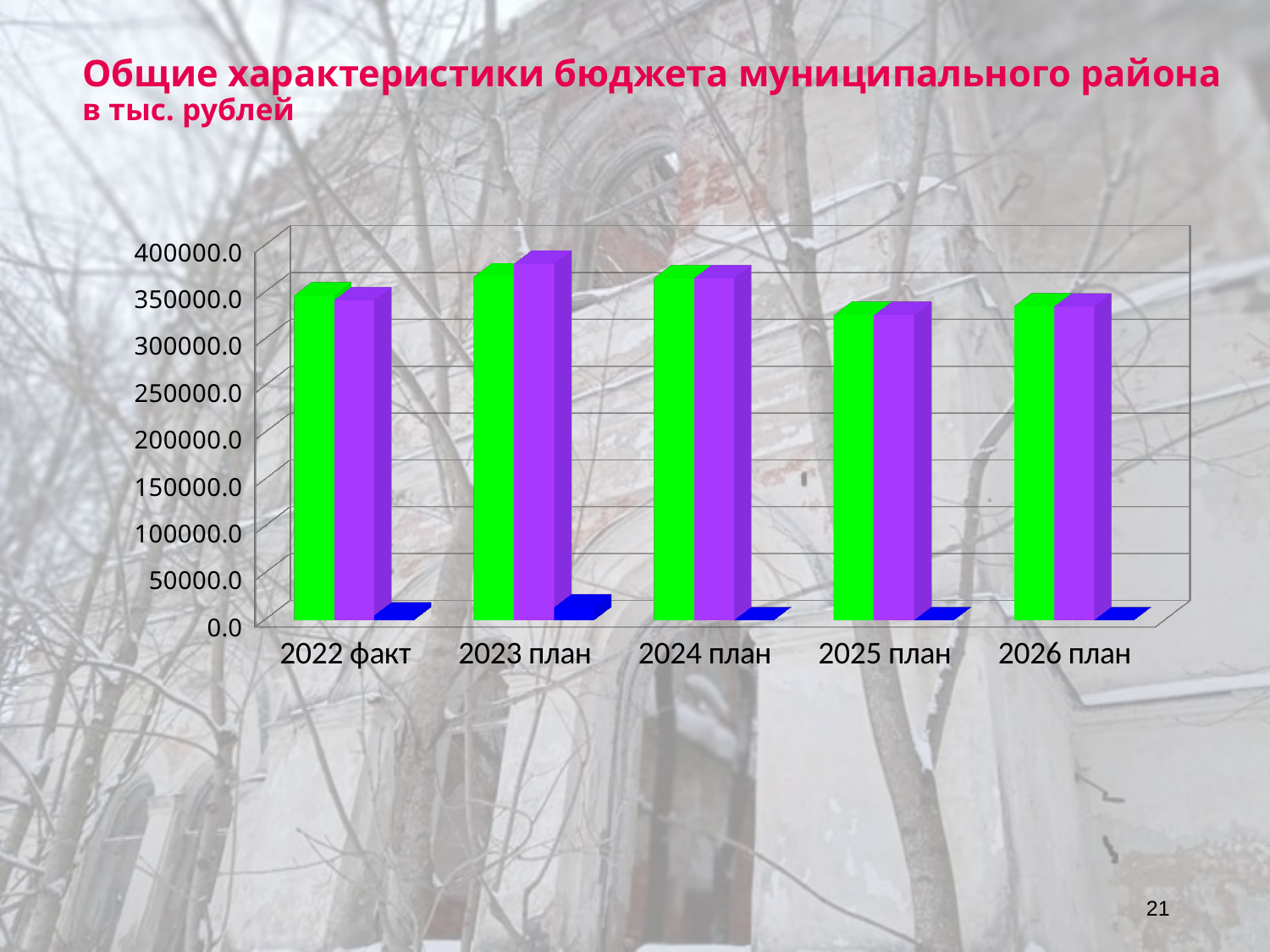
Which category has the tallest purple bar? 2023 план Which category has the tallest blue bar? 2023 план For 2023 план, which bar is taller, the green one or the purple one? the purple one How many categories are shown on the x axis of the chart? 5 What is the title of the chart on the slide? Общие характеристики бюджета муниципального района Is the value of the blue bar for 2023 план greater or less than 50000.0? less Is the value of the purple bar for 2023 план greater or less than 350000.0? greater Is the value of the green bar for 2022 факт greater or less than 300000.0? greater Do the green bars rise or fall from 2023 план to 2025 план? fall What kind of chart is shown on the slide? bar chart In what units are the values on the chart expressed, according to the slide? в тыс. рублей